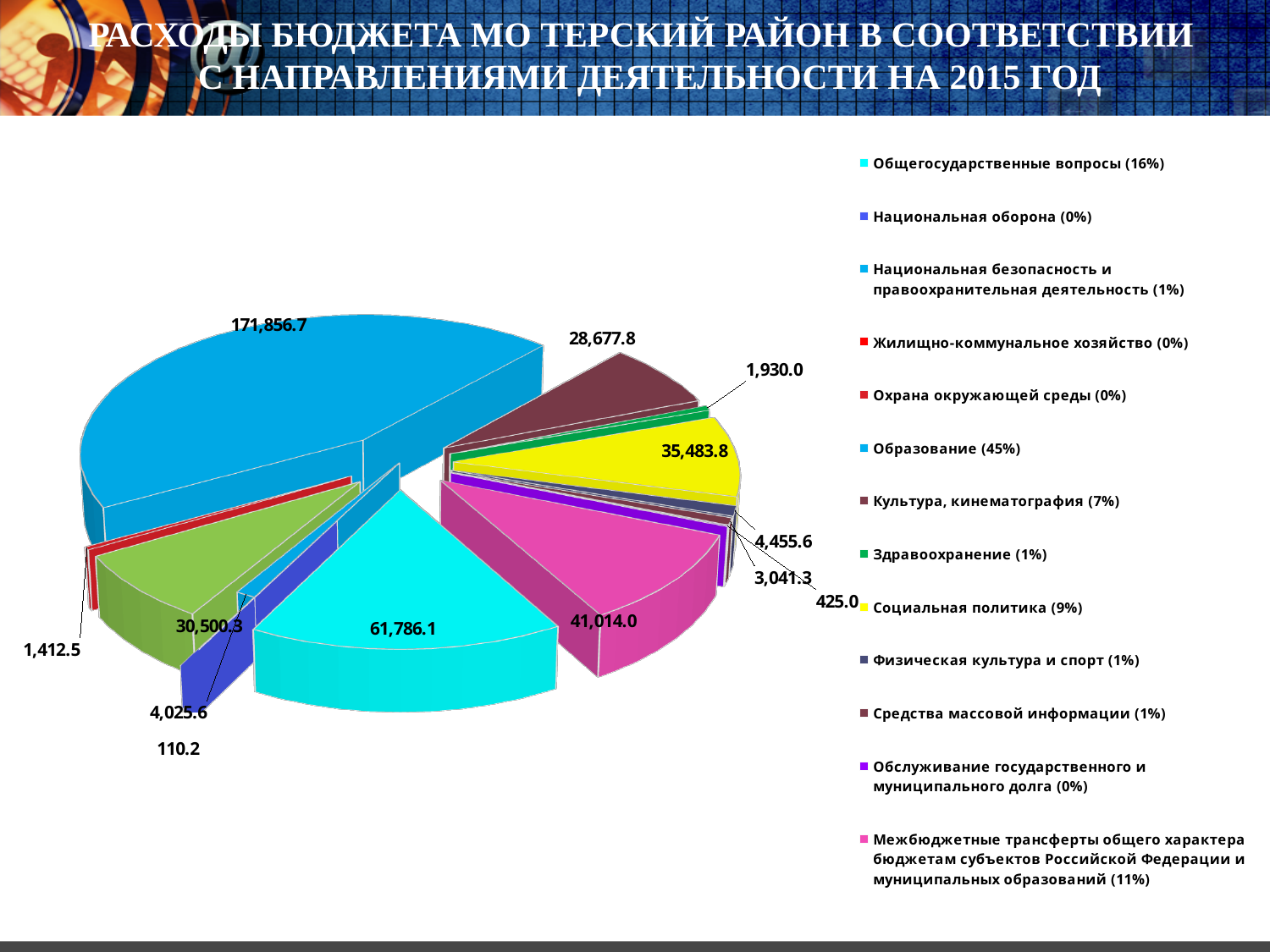
What share of the pie does Общегосударственные вопросы represent according to the legend? 16% What share of the pie does Образование represent according to the legend? 45% How many categories does the legend of the pie chart list? 13 Which category has the largest slice in the pie chart? Образование What is the value shown for the largest slice of the pie chart? 171,856.7 What kind of chart is shown on the slide? pie chart What is the value labelled on the Культура, кинематография slice? 28,677.8 What is the value labelled on the Общегосударственные вопросы slice? 61,786.1 Which is larger: the Социальная политика slice or the Культура, кинематография slice? Социальная политика What is the difference between the Общегосударственные вопросы value (61,786.1) and the Межбюджетные трансферты value (41,014.0)? 20,772.1 What is the smallest data label shown on the pie chart? 110.2 What is the value labelled on the Социальная политика slice? 35,483.8